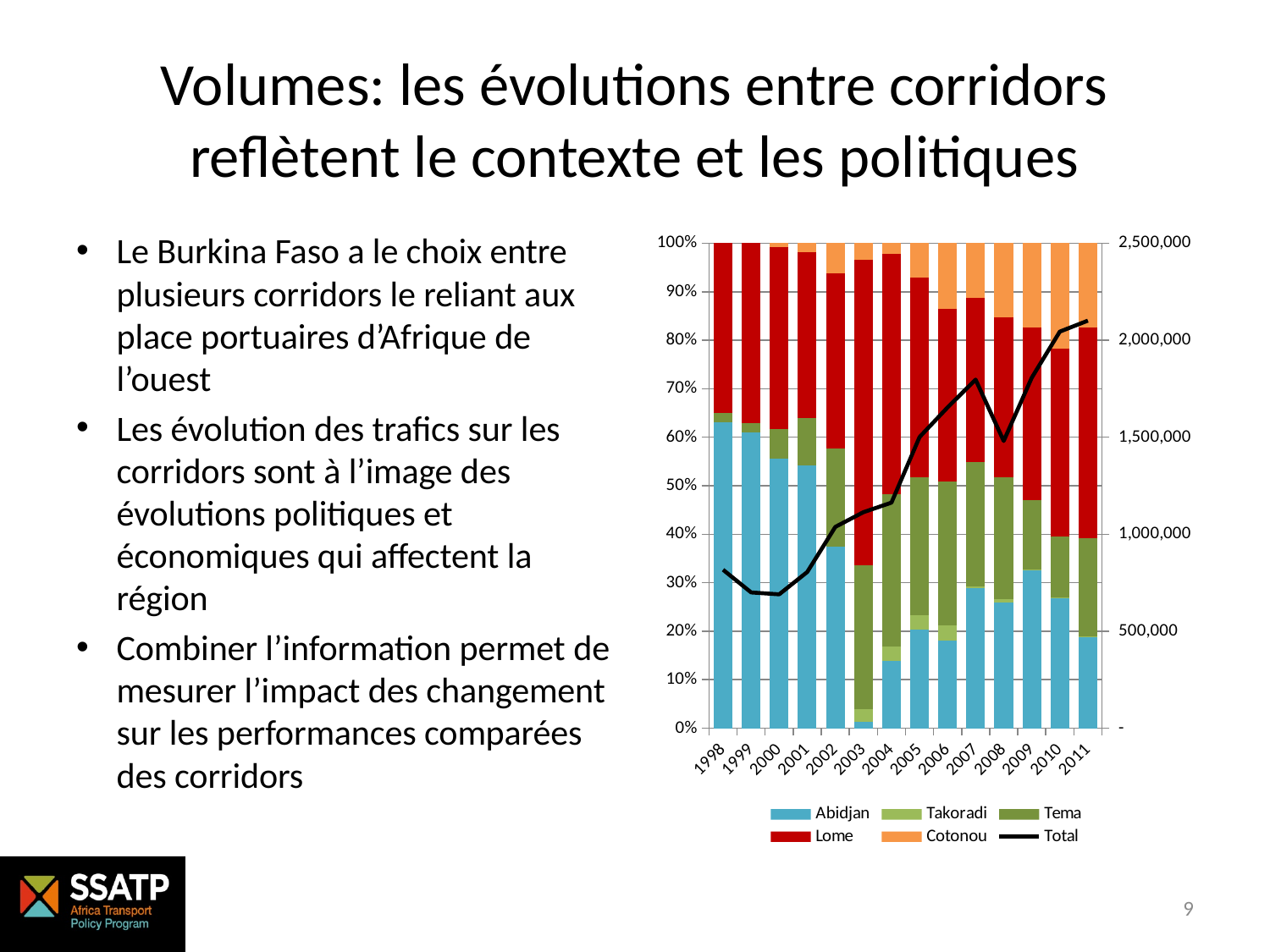
Which series is shown in blue at the bottom of the stacked bars? Abidjan Is the Abidjan share in 2003 greater or less than 10%? less How many series does the chart legend list? 6 Is the Abidjan share in 1998 greater or less than 60%? greater Which series is drawn as a black line in the chart? Total Does the Total line generally rise or fall from 1998 to 2011? rise Is the Total value in 1999 greater or less than 1,000,000? less How many years are shown on the x axis of the chart? 14 What kind of chart is shown on the slide? Stacked bar chart with a line In which year is the Abidjan share the lowest? 2003